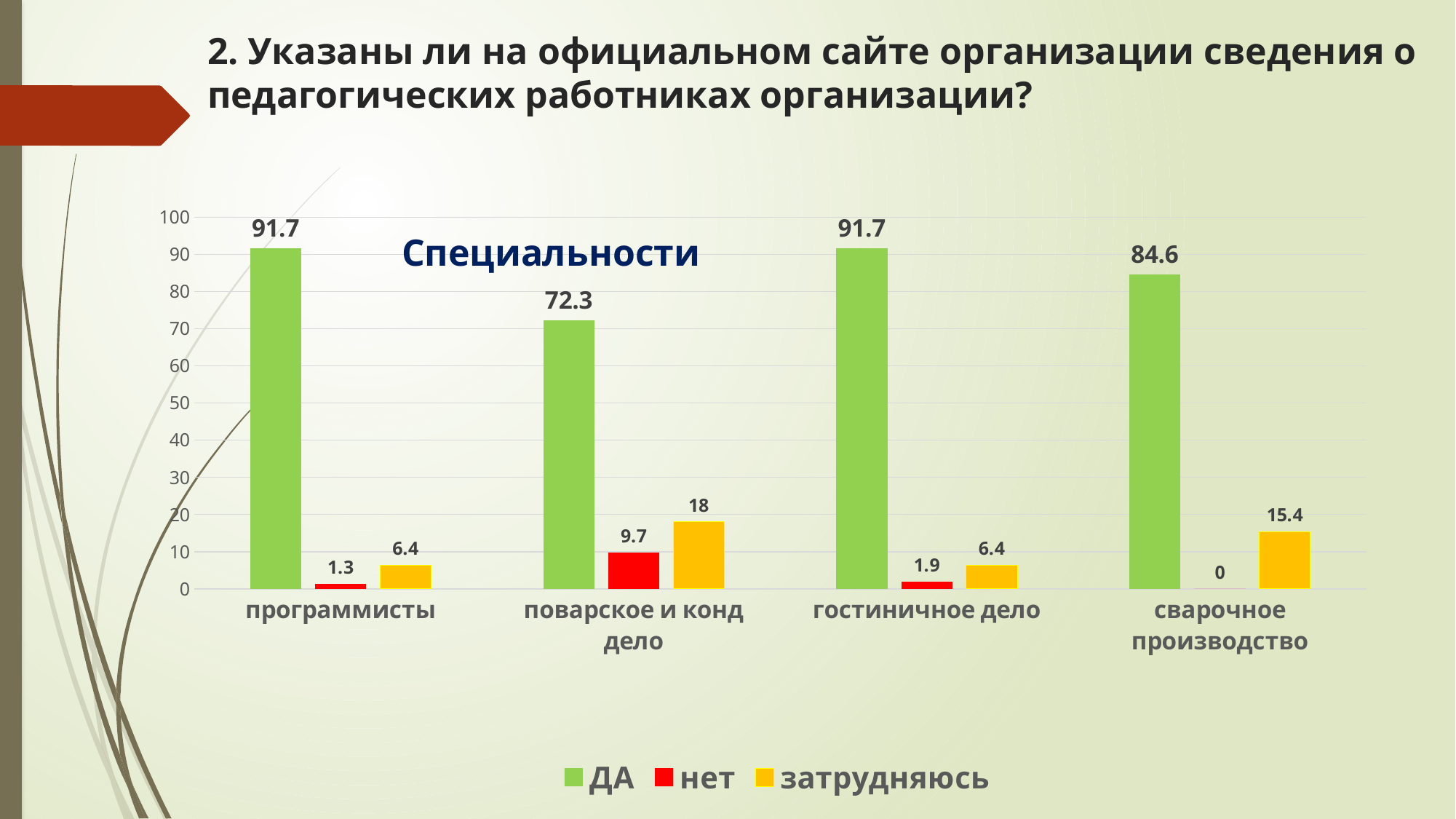
What is the value of затрудняюсь for сварочное производство? 15.4 What is the title of the chart? Специальности Which category has the lowest ДА value? поварское и конд дело How many series does the legend list? 3 What is the value of ДА for программисты? 91.7 How many categories are shown on the x axis? 4 What kind of chart is shown on the slide? bar chart What is the difference between the ДА values for программисты and поварское и конд дело? 19.4 What is the value of нет for сварочное производство? 0 What is the value of нет for поварское и конд дело? 9.7 Which is larger: the затрудняюсь value for поварское и конд дело or for сварочное производство? поварское и конд дело Which category has the highest затрудняюсь value? поварское и конд дело